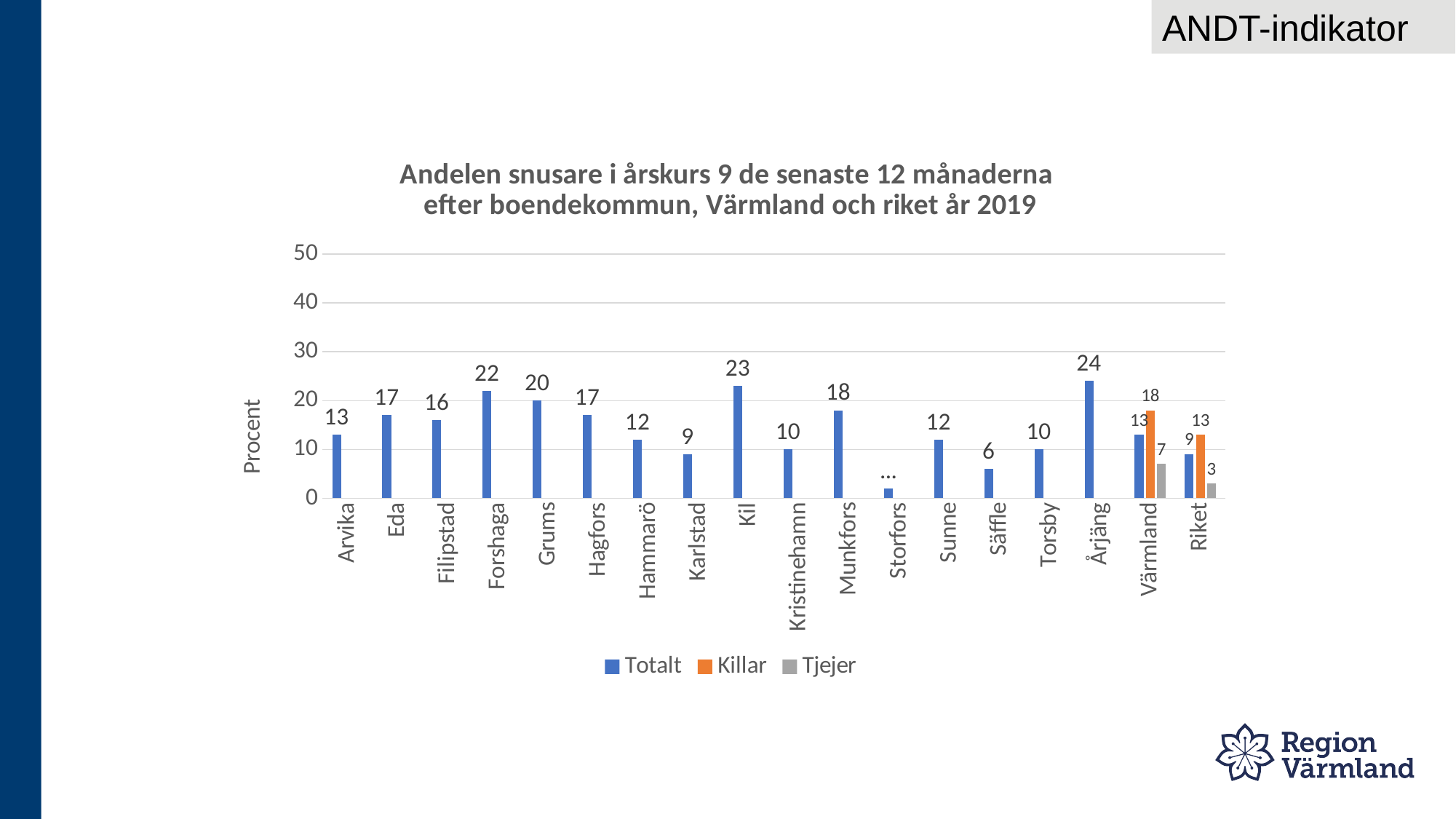
What is the difference between the Totalt values for Forshaga and Arvika? 9 What is the label on the vertical axis? Procent How many categories are shown on the x axis? 18 What is the Tjejer value for Riket? 3 Which municipality has the lowest labelled Totalt value? Säffle What kind of chart is shown on the slide? Bar chart How many series does the legend list? 3 Which municipality has the highest Totalt value? Årjäng What is the Killar value for Värmland? 18 Is the Totalt value for Kil greater or less than 20? greater Which has a higher Totalt value, Grums or Munkfors? Grums What is the Totalt value for Kil? 23